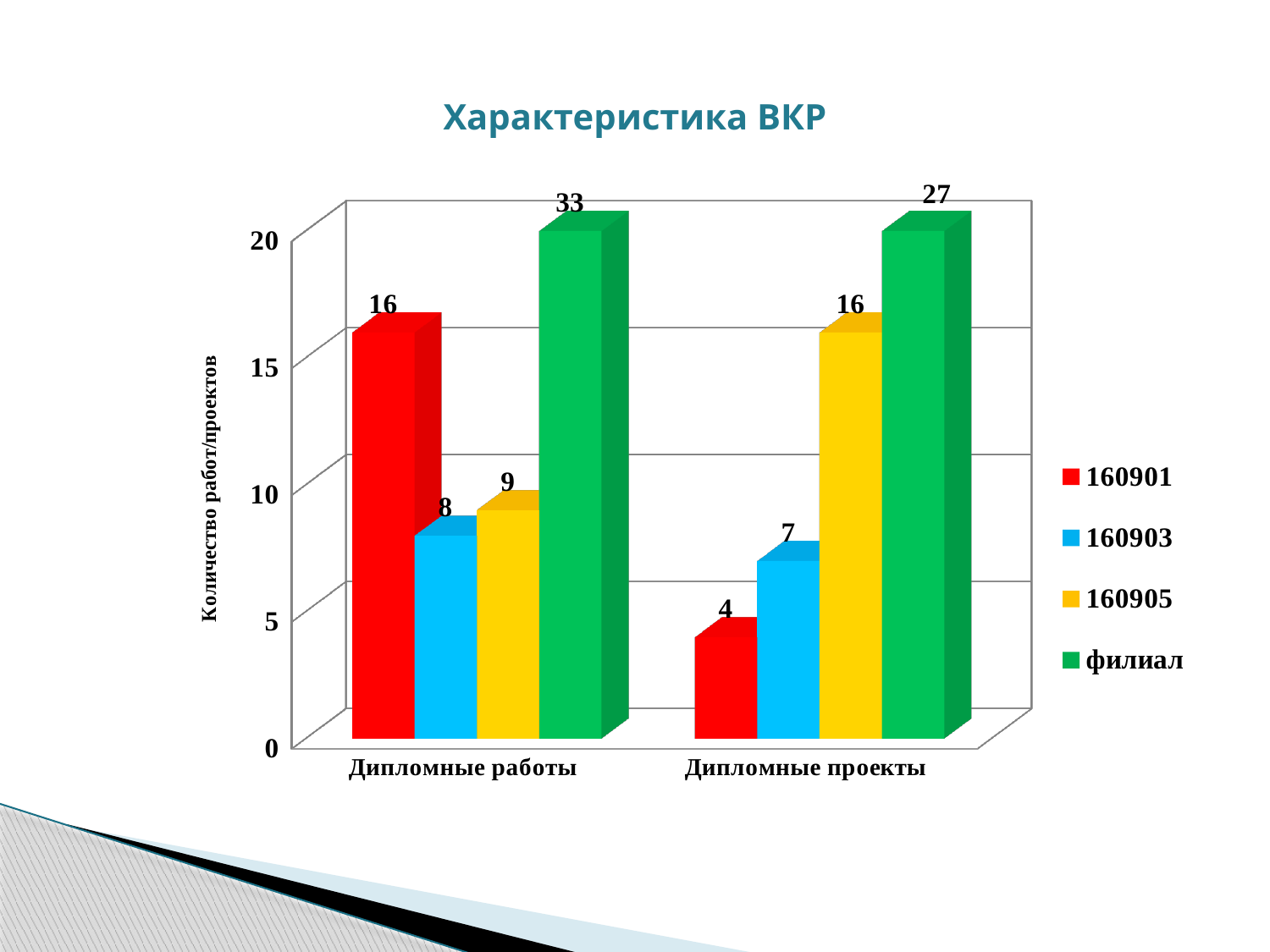
How many categories are shown on the x axis? 2 What is the value for 160901 in the Дипломные работы category? 16 How many series does the legend list? 4 Which series has the highest value in the Дипломные работы category? филиал What is the value for филиал in the Дипломные проекты category? 27 What is the value for 160905 in the Дипломные проекты category? 16 Which is larger: the value for 160905 in Дипломные работы or in Дипломные проекты? Дипломные проекты What is the difference between the филиал values for Дипломные работы and Дипломные проекты? 6 What kind of chart is shown on the slide? Bar chart Which series has the lowest value in the Дипломные проекты category? 160901 What is the value for 160903 in the Дипломные работы category? 8 What is the title of the chart? Характеристика ВКР